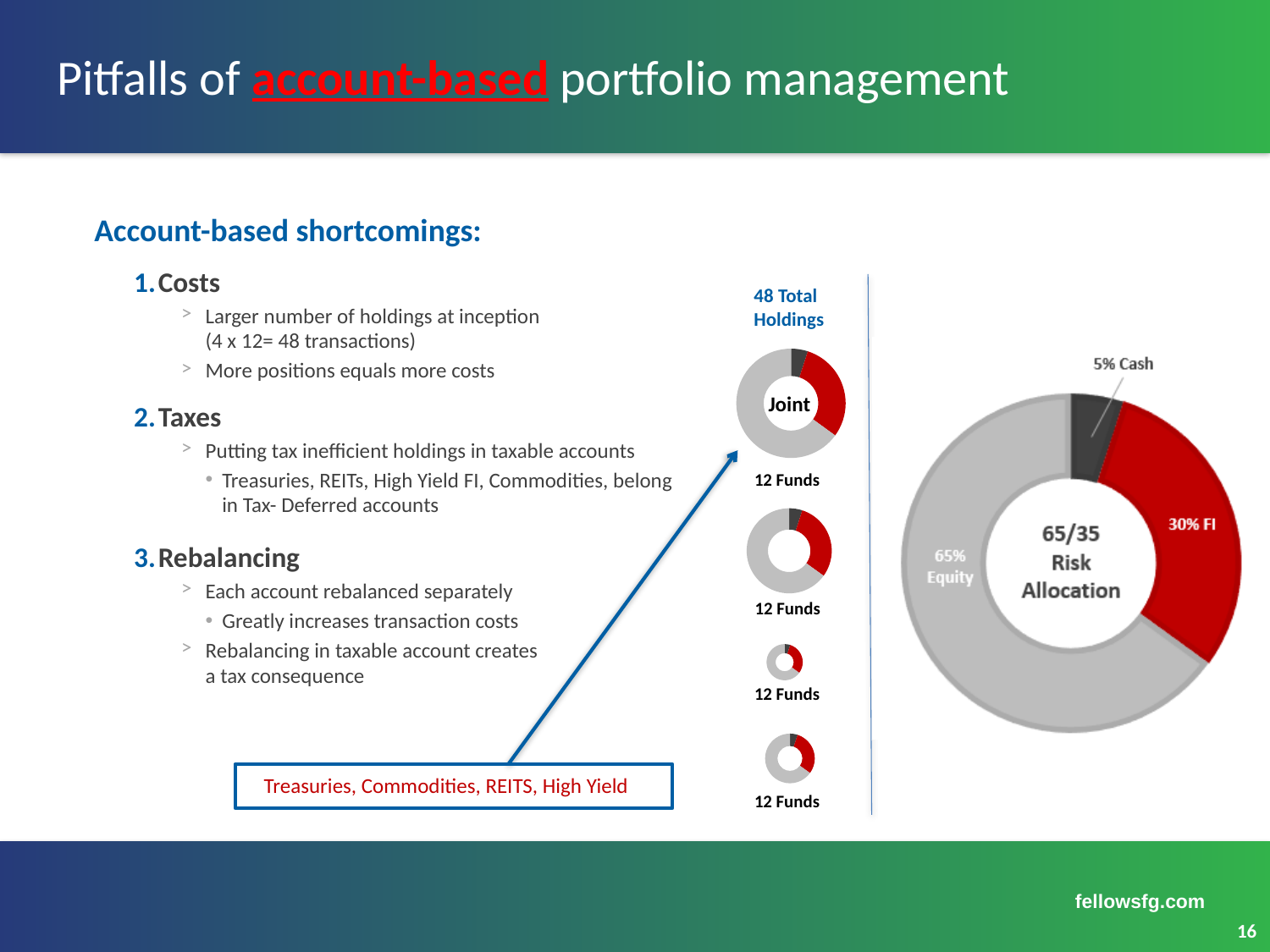
In the large donut chart on the right, what share is labelled for FI? 30% What label appears above the column of small donut charts? 48 Total Holdings What kind of chart is the large chart on the right of the slide? Pie (donut) chart How many slices does the large donut chart on the right have? 3 In the large donut chart on the right, which slice is the largest? Equity What text is written in the centre of the large donut chart on the right? 65/35 Risk Allocation How many small donut charts are shown in the column to the left of the large donut chart? 4 In the large donut chart on the right, what share is labelled for Equity? 65% In the large donut chart on the right, what share is labelled for Cash? 5% In the large donut chart on the right, which is larger, the FI slice or the Cash slice? FI In the large donut chart on the right, how many percentage points larger is the Equity share than the FI share? 35 In the large donut chart on the right, which slice is the smallest? Cash